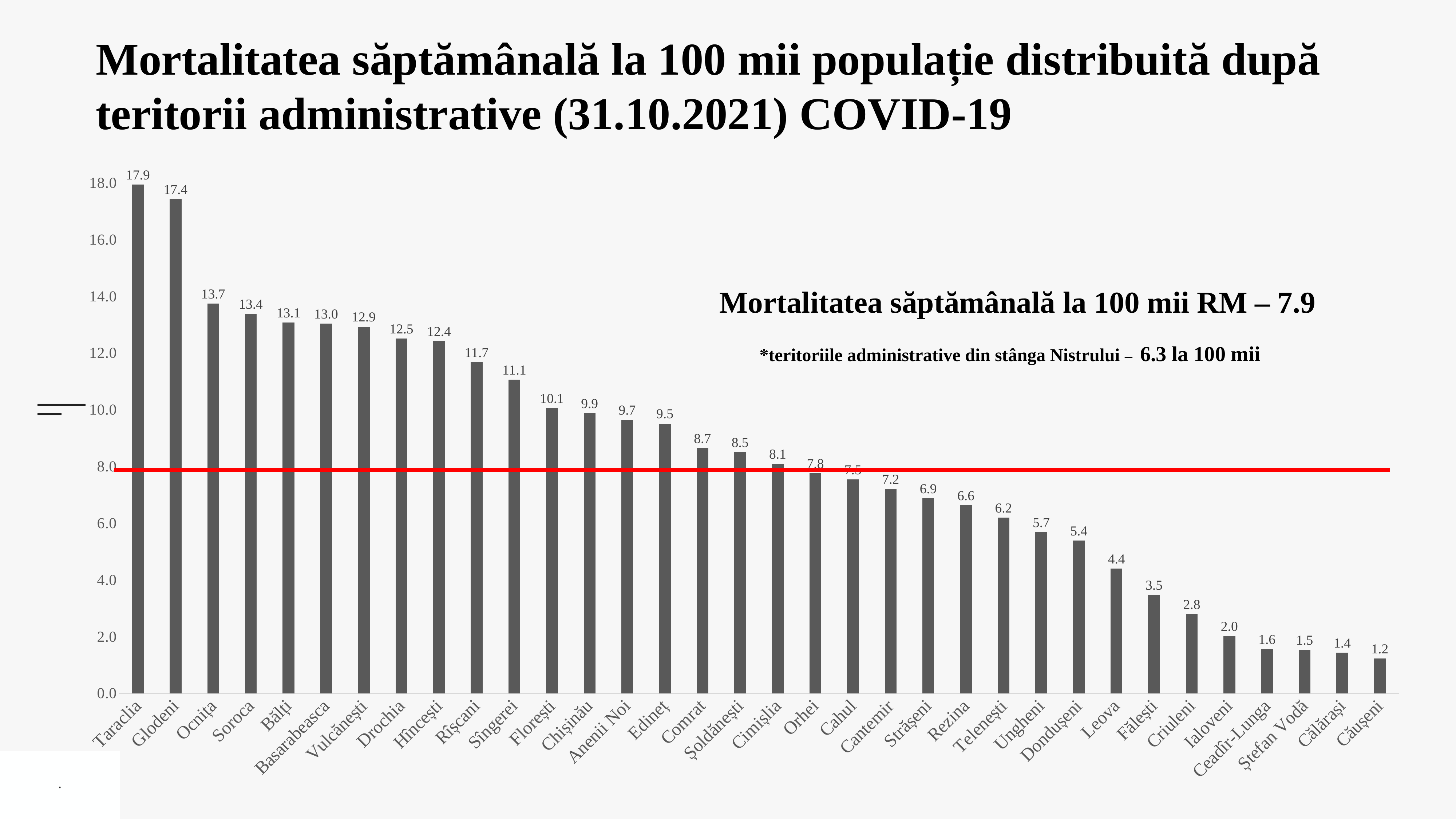
What national weekly mortality value per 100 thousand (RM) is stated on the slide? 7.9 What is the value shown for Soroca? 13.4 Which territory has the highest weekly mortality? Taraclia What kind of chart is shown on the slide? bar chart How many administrative territories are shown on the chart? 34 Which territory has the lowest weekly mortality? Căușeni What is the difference between the values for Taraclia and Glodeni? 0.5 What is the weekly mortality value for Chișinău? 9.9 Is the value for Leova greater or less than 6.0? less Which has a higher value, Edineț or Orhei? Edineț What is the value shown for Ungheni? 5.7 What is the difference between the values for Comrat and Cahul? 1.2